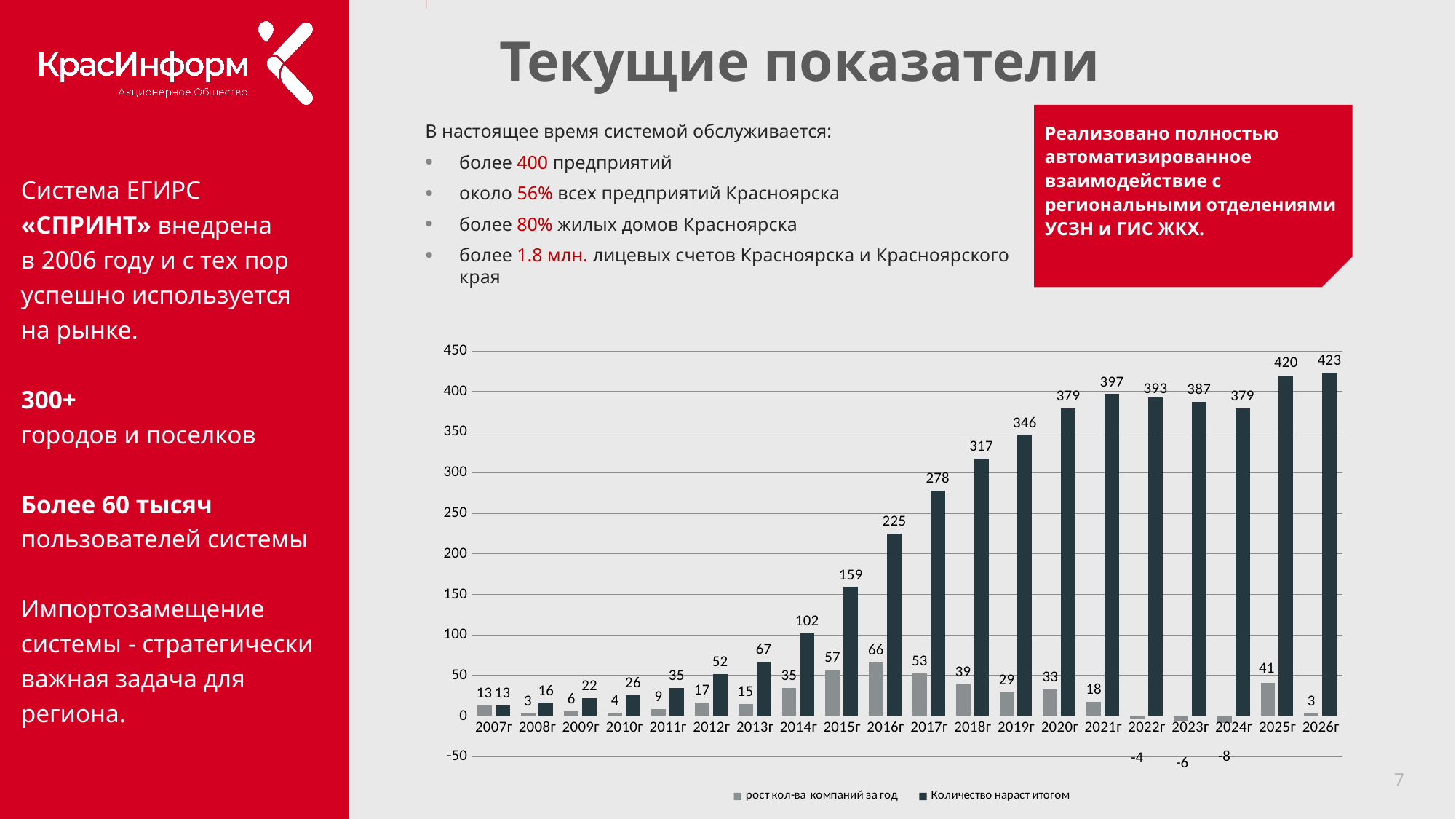
Does 'Количество нараст итогом' generally rise or fall from 2007г to 2021г? rise What is the value of 'Количество нараст итогом' for 2026г? 423 Which year has the highest value of 'рост кол-ва компаний за год'? 2016г What is the value of 'Количество нараст итогом' for 2015г? 159 What type of chart is shown on the slide? bar chart Which is larger: 'Количество нараст итогом' in 2018г or in 2019г? 2019г How many years (categories) are shown on the x axis of the chart? 20 Which year has the lowest value of 'рост кол-ва компаний за год'? 2024г What is the value of 'рост кол-ва компаний за год' for 2022г? -4 How many series does the chart legend list? 2 What is the value of 'рост кол-ва компаний за год' for 2016г? 66 What is the difference between 'Количество нараст итогом' in 2021г and in 2020г? 18